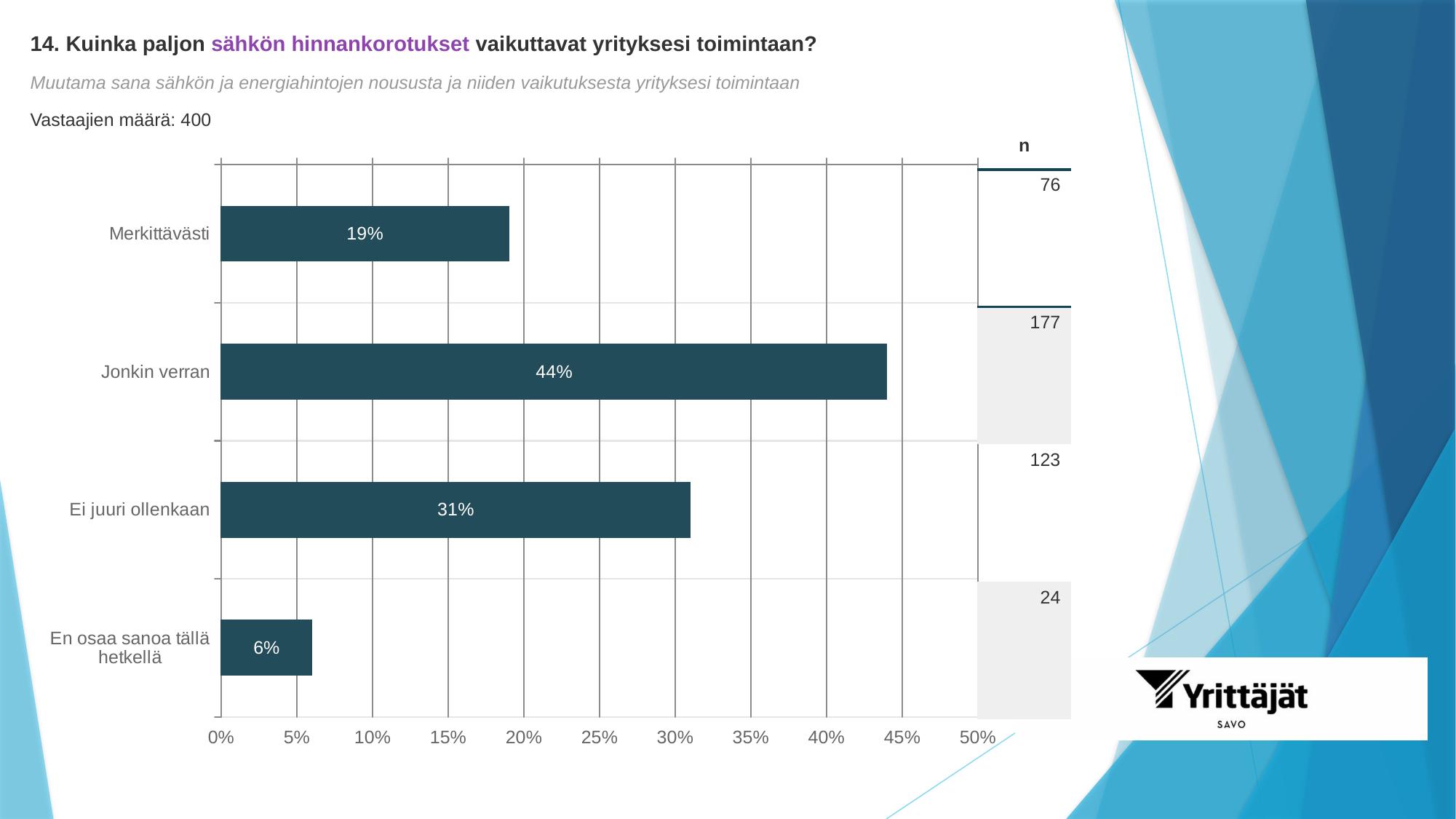
What kind of chart is shown on the slide? Bar chart What is the difference between the n values for "Jonkin verran" and "Merkittävästi"? 101 Which category has the highest percentage? Jonkin verran What percentage of respondents answered "Jonkin verran"? 44% What is the difference in percentage points between "Jonkin verran" and "Ei juuri ollenkaan"? 13 percentage points How many categories are shown in the chart? 4 What is the total number of respondents stated on the slide (Vastaajien määrä)? 400 What is the n value (number of respondents) for "Ei juuri ollenkaan"? 123 Which category has the lowest percentage? En osaa sanoa tällä hetkellä Which is larger, the percentage for "Merkittävästi" or for "Ei juuri ollenkaan"? Ei juuri ollenkaan What is the n value for "En osaa sanoa tällä hetkellä"? 24 What percentage of respondents answered "Merkittävästi"? 19%